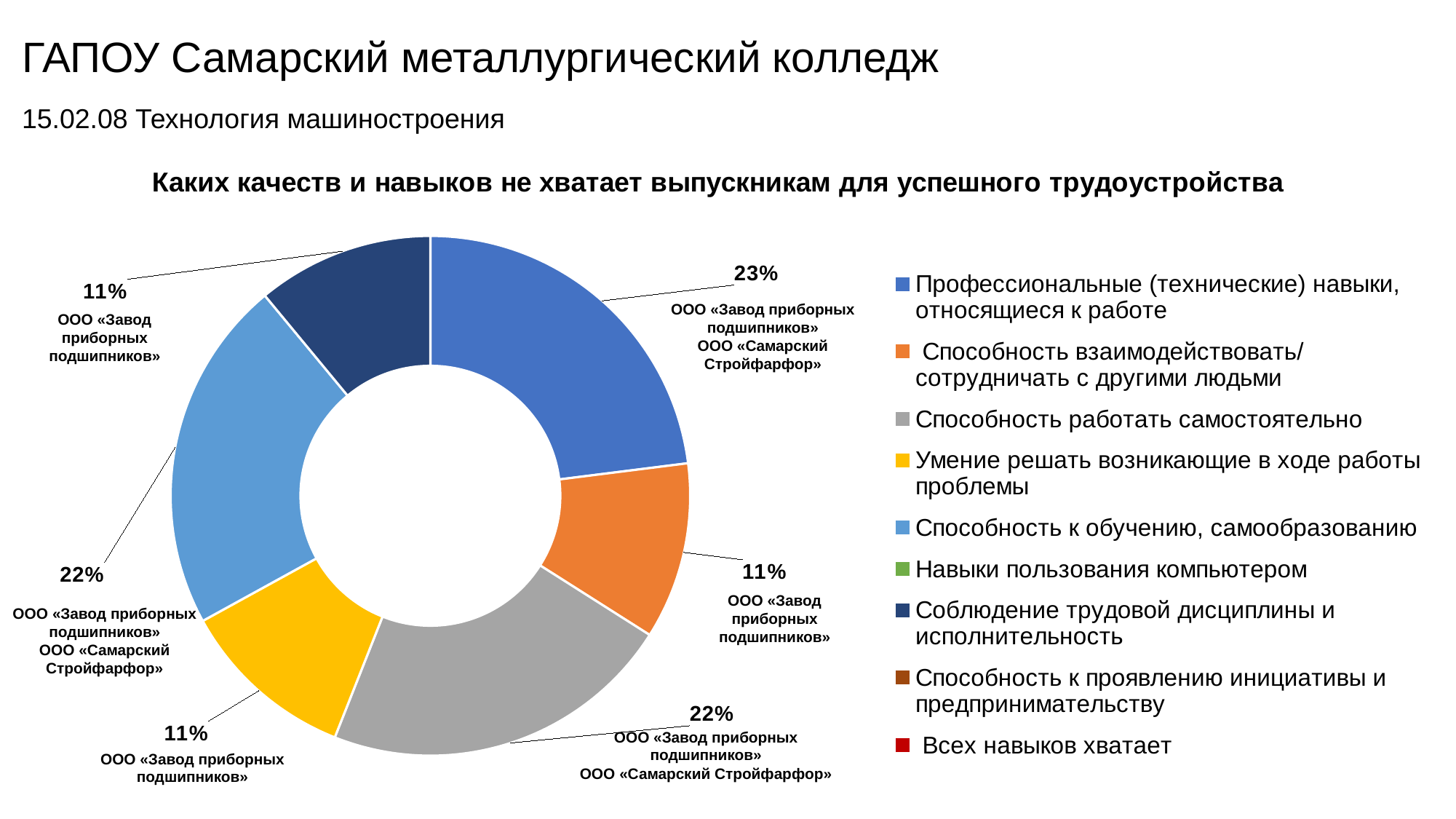
What percentage is shown for «Умение решать возникающие в ходе работы проблемы»? 11% What percentage is shown for «Профессиональные (технические) навыки, относящиеся к работе»? 23% Which is larger: the share for «Способность к обучению, самообразованию» or the share for «Способность взаимодействовать/сотрудничать с другими людьми»? Способность к обучению, самообразованию What kind of chart is shown on the slide? Doughnut (pie) chart Which category has the largest share of the chart? Профессиональные (технические) навыки, относящиеся к работе What is the title of the chart? Каких качеств и навыков не хватает выпускникам для успешного трудоустройства How many entries does the legend list? 9 How many slices with data labels are shown in the chart? 6 What colour is the slice for «Умение решать возникающие в ходе работы проблемы»? Yellow What is the difference between the share for «Профессиональные (технические) навыки, относящиеся к работе» and the share for «Способность взаимодействовать/сотрудничать с другими людьми»? 12% What percentage is shown for «Способность работать самостоятельно»? 22% What percentage is shown for «Соблюдение трудовой дисциплины и исполнительность»? 11%